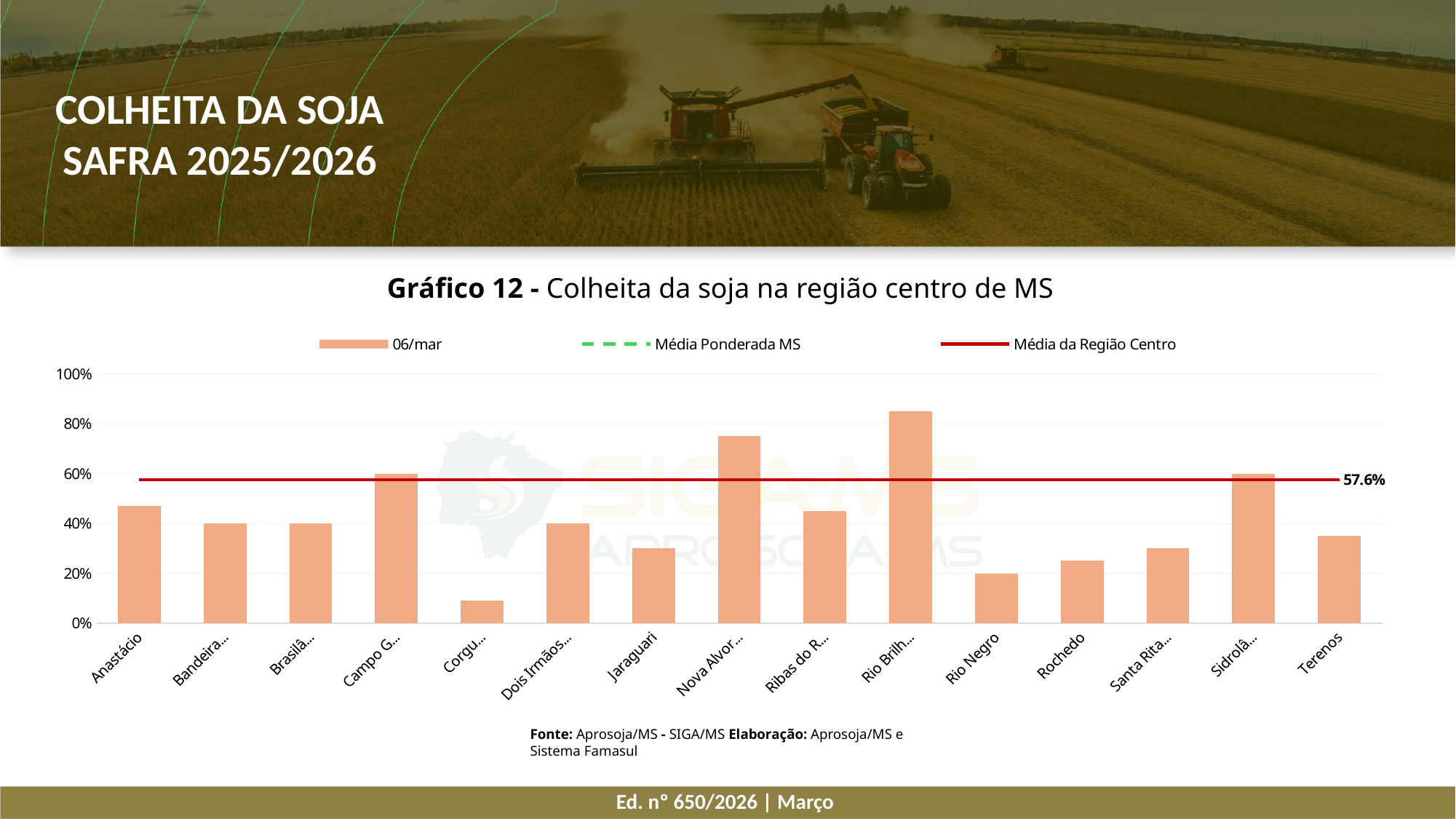
What is the title of the chart? Gráfico 12 - Colheita da soja na região centro de MS Is the value for Anastácio greater or less than 40%? greater Is the value for Jaraguari greater or less than 40%? less Which is larger, the value for Terenos or the value for Rochedo? Terenos Which is larger, the value for Anastácio or the value for Rio Negro? Anastácio What kind of chart is shown on the slide? bar chart How many entries does the legend list? 3 How many municipalities (categories) are plotted on the x axis? 15 What value is printed for the Média da Região Centro line? 57.6% Is the value for Rio Negro greater or less than 40%? less What legend label is given to the bars? 06/mar